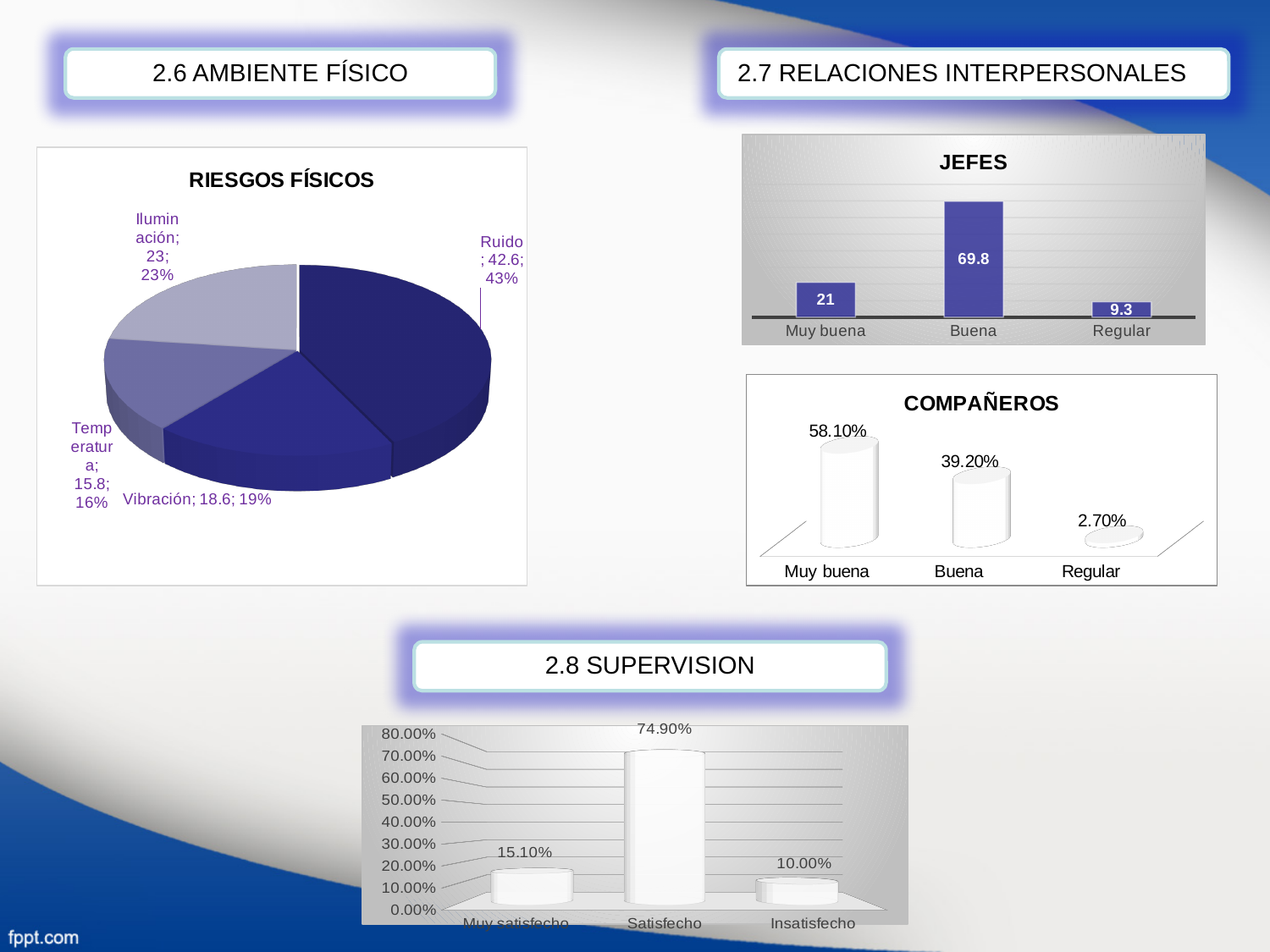
In the 2.8 SUPERVISION chart, what is the value for Satisfecho? 74.90% In the COMPAÑEROS chart, what is the value for Muy buena? 58.10% In the JEFES chart, what is the difference between the values for Muy buena and Regular? 11.7 In the RIESGOS FÍSICOS chart, what is the value for Vibración? 18.6 In the RIESGOS FÍSICOS chart, what kind of chart is shown? pie chart In the RIESGOS FÍSICOS chart, which category has the smallest slice? Temperatura In the JEFES chart, what is the value for Buena? 69.8 In the 2.8 SUPERVISION chart, what is the difference between the values for Muy satisfecho and Insatisfecho? 5.10% In the RIESGOS FÍSICOS chart, what share of the pie does Ruido have? 43% In the JEFES chart, which category has the lowest value? Regular In the RIESGOS FÍSICOS chart, how many slices does the pie have? 4 In the COMPAÑEROS chart, which is larger, the value for Buena or the value for Regular? Buena